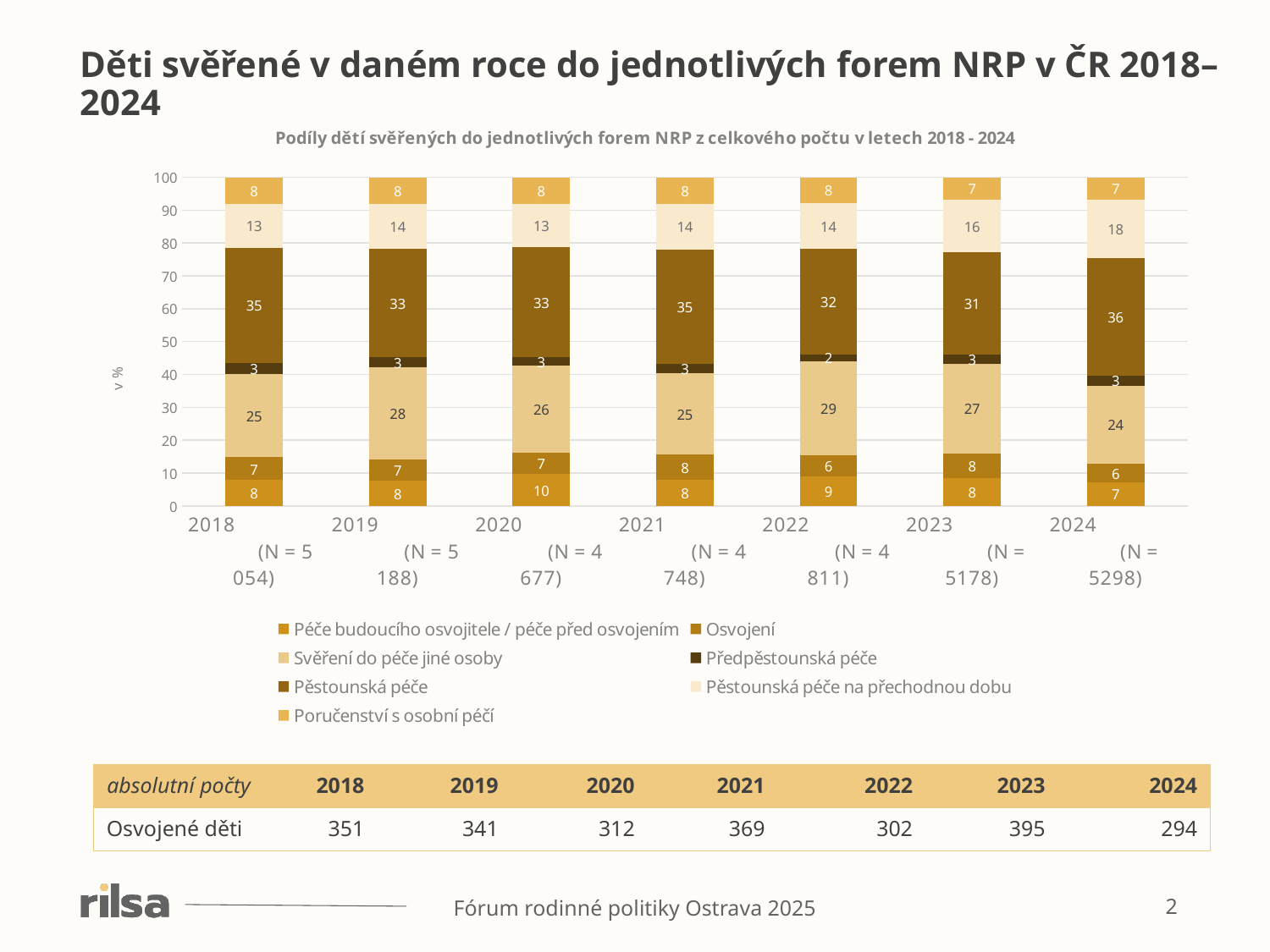
What is the difference between the share of Svěření do péče jiné osoby in 2022 and in 2024? 5 In which year is the share of Pěstounská péče the highest? 2024 How many years (categories) are shown on the x axis of the chart? 7 What is the share of Pěstounská péče na přechodnou dobu in 2023? 16 How many series does the chart legend list? 7 What is the share of Svěření do péče jiné osoby in 2022? 29 Does the share of Pěstounská péče na přechodnou dobu rise or fall from 2021 to 2024? Rises In which year is the share of Pěstounská péče the lowest? 2023 Which year has a larger share of Pěstounská péče na přechodnou dobu, 2018 or 2024? 2024 What is the label of the y axis of the chart? v % What is the share of Pěstounská péče in 2024? 36 What kind of chart is shown on the slide? Stacked bar chart